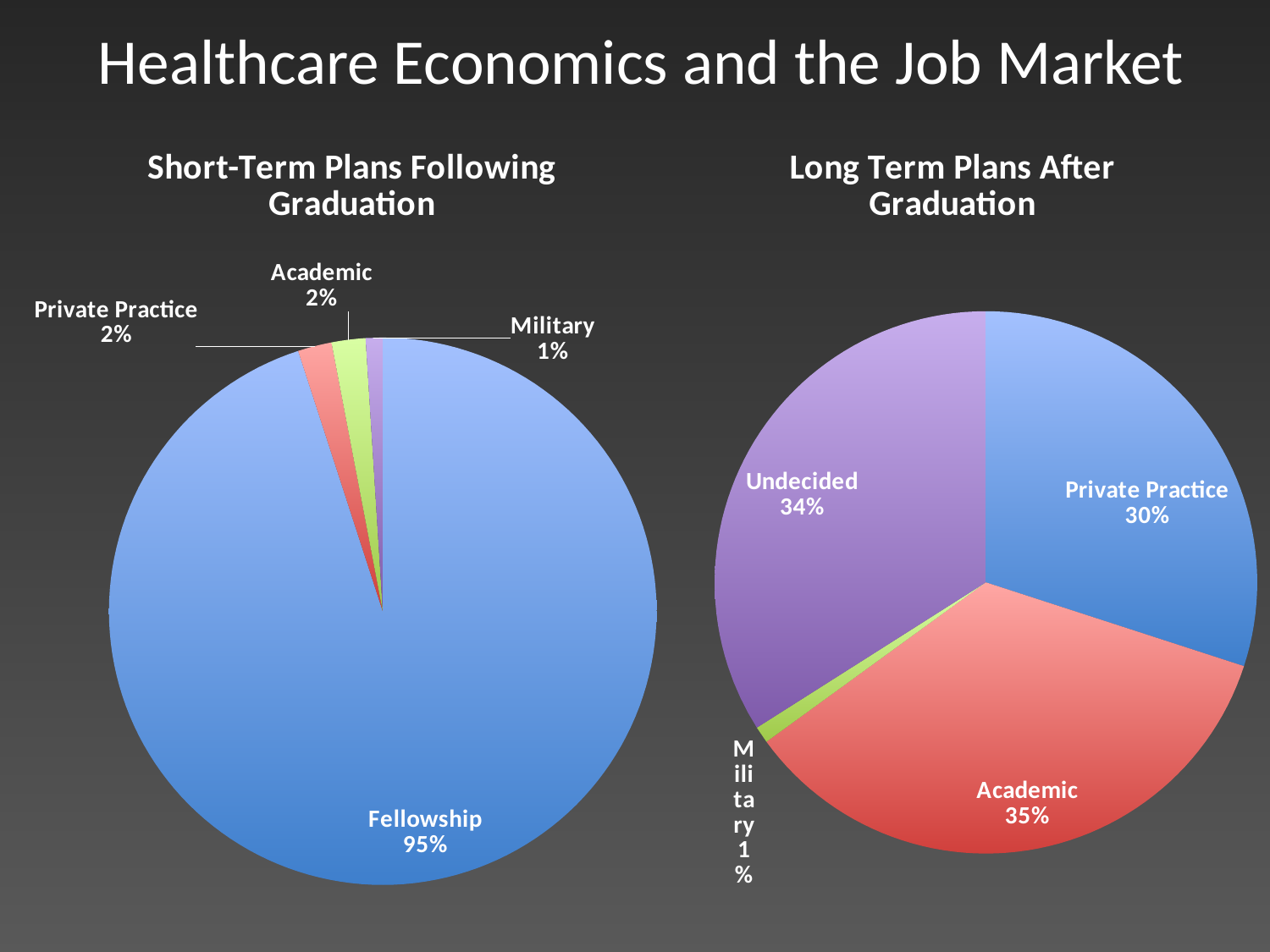
In the 'Short-Term Plans Following Graduation' chart, what is the value for Military? 1% In the 'Long Term Plans After Graduation' chart, what is the difference between Academic and Private Practice? 5% In the 'Short-Term Plans Following Graduation' chart, what share of the pie is Fellowship? 95% In the 'Long Term Plans After Graduation' chart, what share of the pie is Undecided? 34% In the 'Long Term Plans After Graduation' chart, how many categories are shown? 4 In the 'Short-Term Plans Following Graduation' chart, how many categories are shown? 4 What is the title of the chart on the right side of the slide? Long Term Plans After Graduation In the 'Long Term Plans After Graduation' chart, which category is the smallest? Military What kind of chart is the 'Short-Term Plans Following Graduation' chart? Pie chart In the 'Short-Term Plans Following Graduation' chart, which category is the largest? Fellowship In the 'Long Term Plans After Graduation' chart, which is larger, Academic or Undecided? Academic In the 'Long Term Plans After Graduation' chart, what is the value for Private Practice? 30%